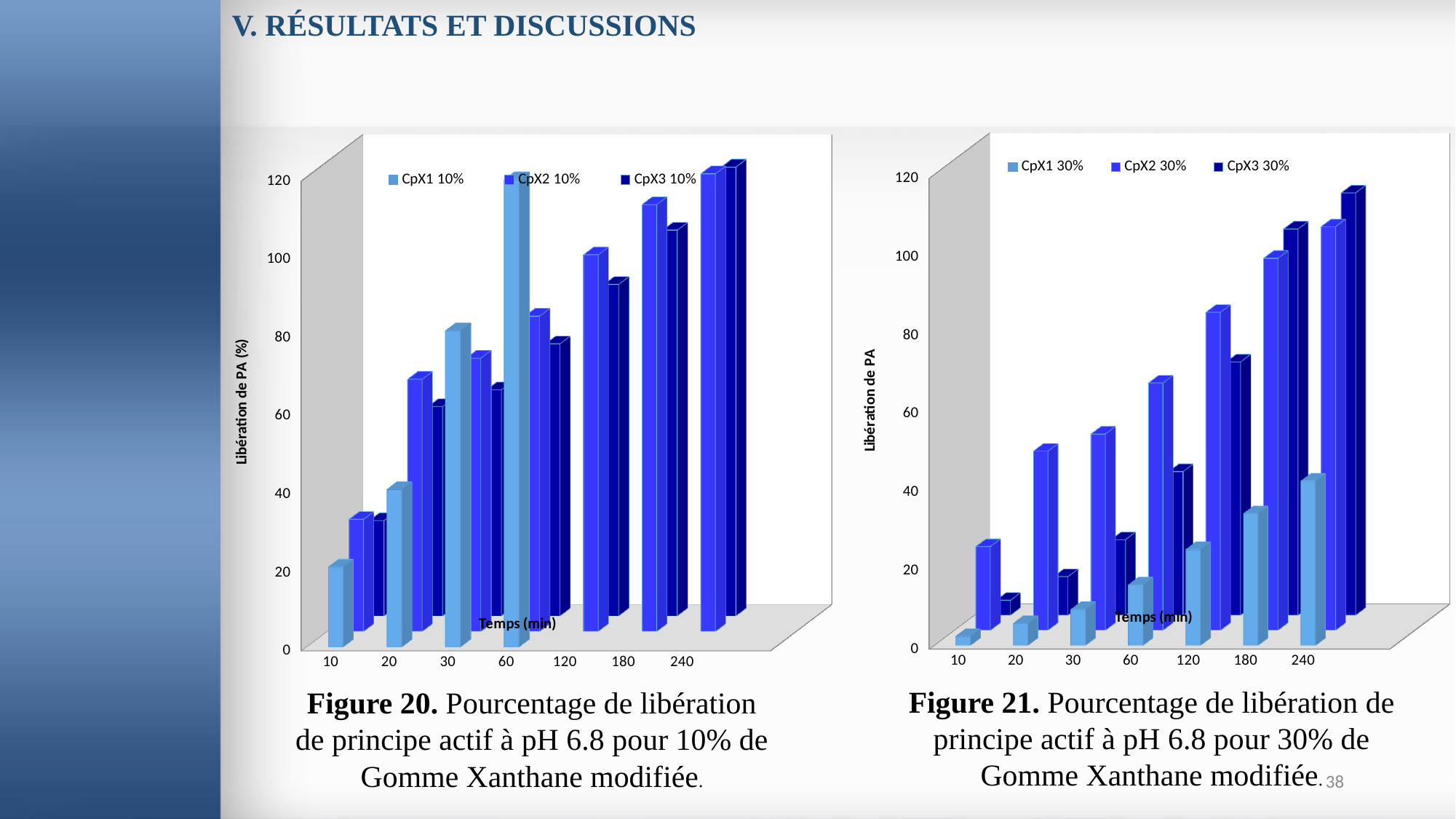
How many series does the legend of Figure 21 list? 3 In Figure 21, is the value for CpX1 30% at 240 min greater or less than 60? less In Figure 21, which is larger at 60 min: CpX2 30% or CpX3 30%? CpX2 30% In Figure 20, is the value for CpX3 10% at 20 min greater or less than 80? less What is the y-axis title of Figure 20? Libération de PA (%) How many time points are shown on the x axis of Figure 20? 7 In Figure 21, do the values for CpX3 30% rise or fall as time increases along the x axis? rise In Figure 21, which series has the lowest value at 240 min? CpX1 30% In Figure 21, which is larger at 180 min: CpX1 30% or CpX3 30%? CpX3 30% What kind of chart is Figure 20? bar chart In Figure 20, is the value for CpX1 10% at 30 min greater or less than 60? greater